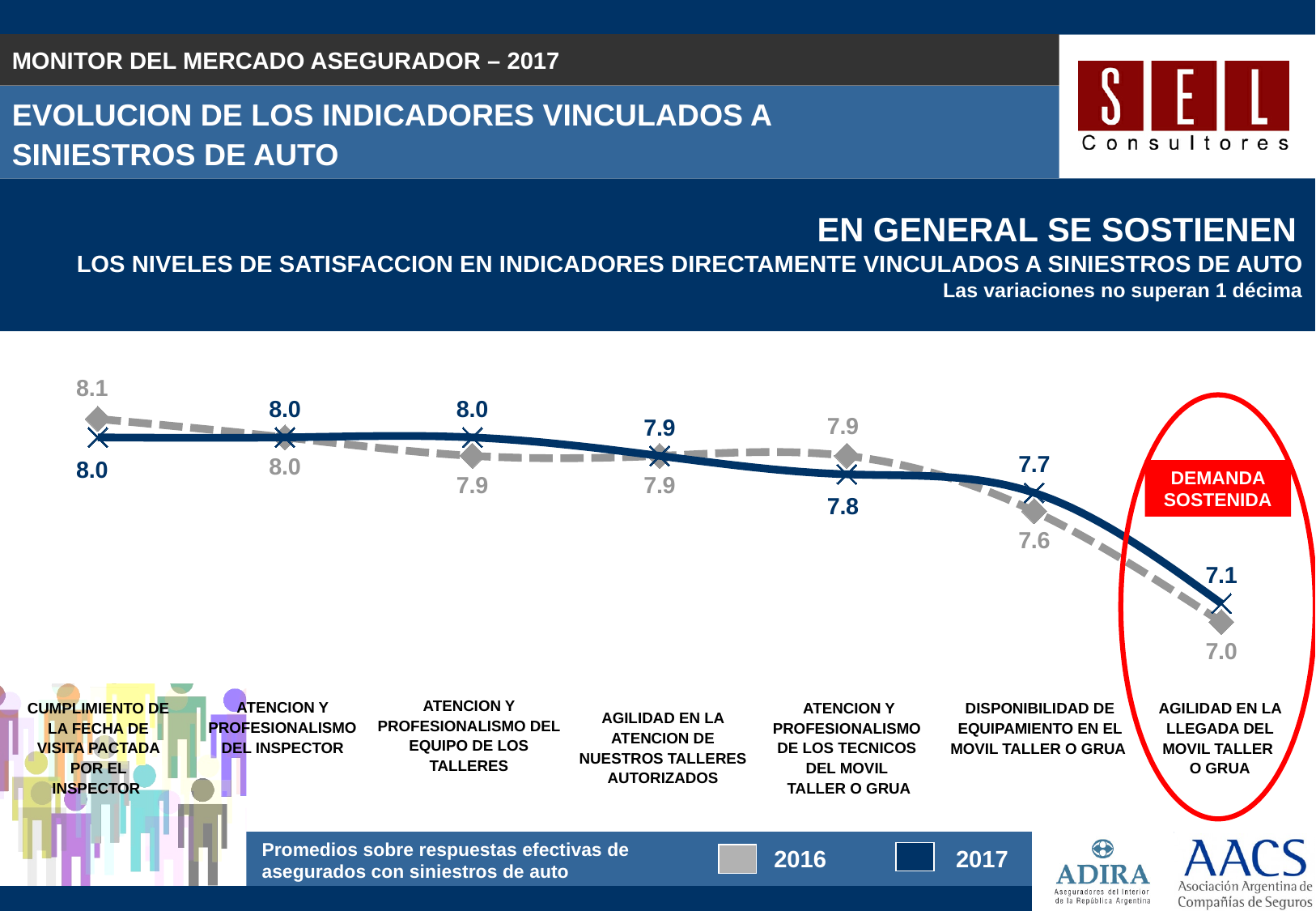
What is the difference between the 2016 and 2017 values for 'Agilidad en la llegada del movil taller o grua'? 0.1 Do the 2017 values generally rise or fall from left to right along the x axis? Fall What is the 2016 value for 'Cumplimiento de la fecha de visita pactada por el inspector'? 8.1 How many categories are plotted along the x axis? 7 For 'Atencion y profesionalismo del equipo de los talleres', which year has the higher value, 2016 or 2017? 2017 What is the 2016 value for 'Disponibilidad de equipamiento en el movil taller o grua'? 7.6 Which category has the lowest 2017 value? Agilidad en la llegada del movil taller o grua How many series does the legend list? 2 Which category has the highest 2016 value? Cumplimiento de la fecha de visita pactada por el inspector What is the 2017 value for 'Agilidad en la llegada del movil taller o grua'? 7.1 What is the 2017 value for 'Atencion y profesionalismo de los tecnicos del movil taller o grua'? 7.8 What type of chart is shown on the slide? Line chart